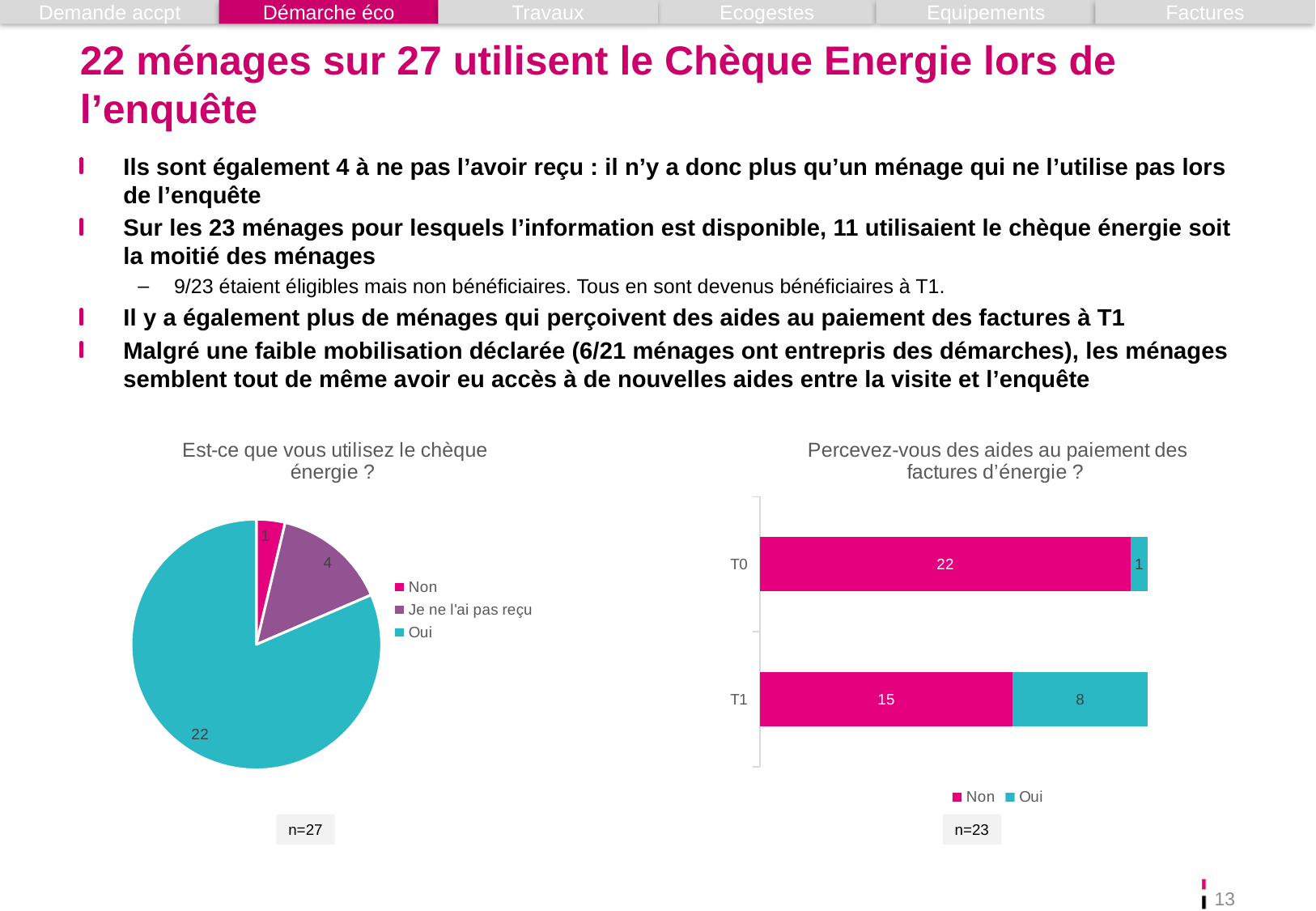
In the pie chart 'Est-ce que vous utilisez le chèque énergie ?', how many households answered 'Oui'? 22 In the chart 'Percevez-vous des aides au paiement des factures d'énergie ?', which is larger: the 'Oui' value for T0 or the 'Oui' value for T1? T1 In the chart 'Percevez-vous des aides au paiement des factures d'énergie ?', what is the 'Non' value for T1? 15 In the chart 'Percevez-vous des aides au paiement des factures d'énergie ?', how many series does the legend list? 2 In the pie chart 'Est-ce que vous utilisez le chèque énergie ?', which category has the smallest slice? Non In the chart 'Percevez-vous des aides au paiement des factures d'énergie ?', what is the 'Oui' value for T0? 1 What type of chart is the one on the right of the slide? Stacked bar chart In the pie chart 'Est-ce que vous utilisez le chèque énergie ?', how many categories does the legend list? 3 In the chart 'Percevez-vous des aides au paiement des factures d'énergie ?', what is the total of the T1 bar? 23 In the pie chart 'Est-ce que vous utilisez le chèque énergie ?', what is the difference between the 'Oui' and 'Je ne l'ai pas reçu' values? 18 What type of chart is the one on the left of the slide? Pie chart In the pie chart 'Est-ce que vous utilisez le chèque énergie ?', how many households answered 'Je ne l'ai pas reçu'? 4